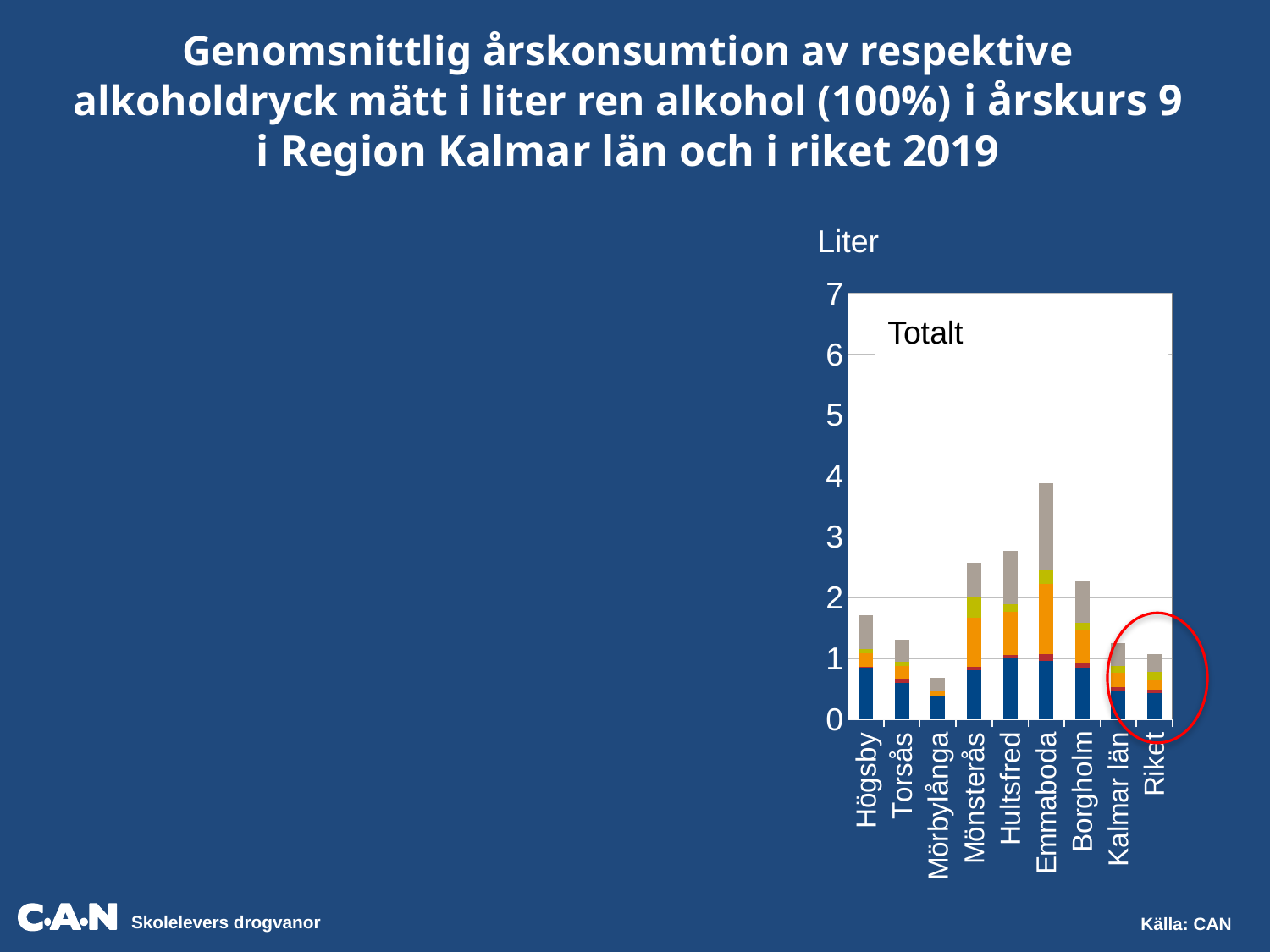
Is the total value for Mörbylånga greater or less than 1 liter? less Is the total value for Emmaboda greater or less than 3 liters? greater Which has the larger total bar, Emmaboda or Hultsfred? Emmaboda What kind of chart is shown on the slide? Stacked bar chart Which category has the highest total bar in the chart? Emmaboda Which category has the lowest total bar in the chart? Mörbylånga Which has the larger total bar, Mönsterås or Torsås? Mönsterås How many categories are shown along the x axis of the chart? 9 Is the total value for Kalmar län greater or less than 2 liters? less What unit is shown as the label above the y axis of the chart? Liter